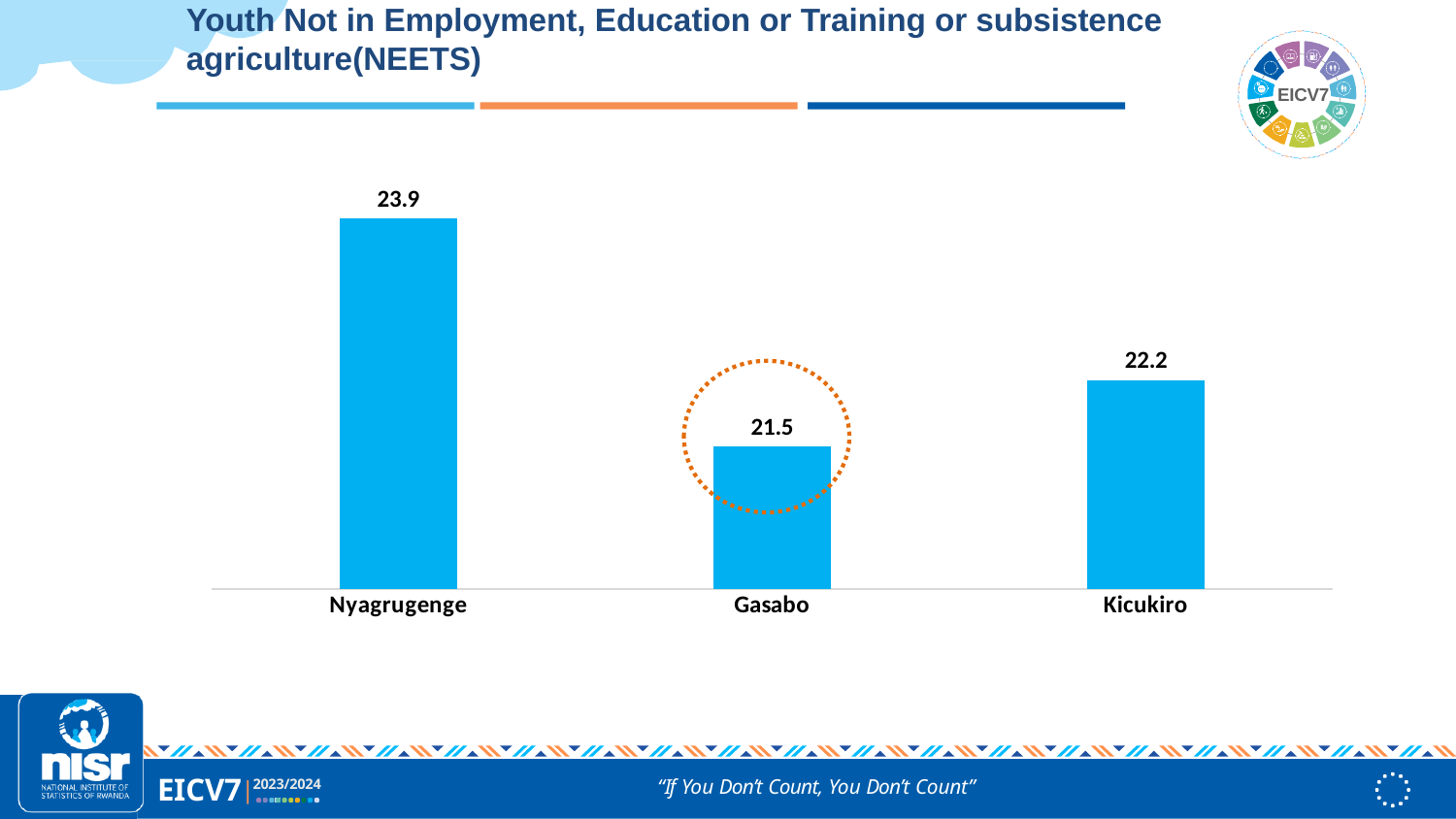
What is the difference between the values for Nyagrugenge and Gasabo? 2.4 Which category has the highest value? Nyagrugenge What is the value for Kicukiro? 22.2 How many categories are shown in the chart? 3 Which is larger, the value for Nyagrugenge or the value for Kicukiro? Nyagrugenge What is the value for Gasabo? 21.5 What is the title of the slide? Youth Not in Employment, Education or Training or subsistence agriculture(NEETS) What is the value for Nyagrugenge? 23.9 What kind of chart is shown on the slide? bar chart What is the difference between the values for Kicukiro and Gasabo? 0.7 Which category's bar is circled with a dotted orange outline? Gasabo Which category has the lowest value? Gasabo